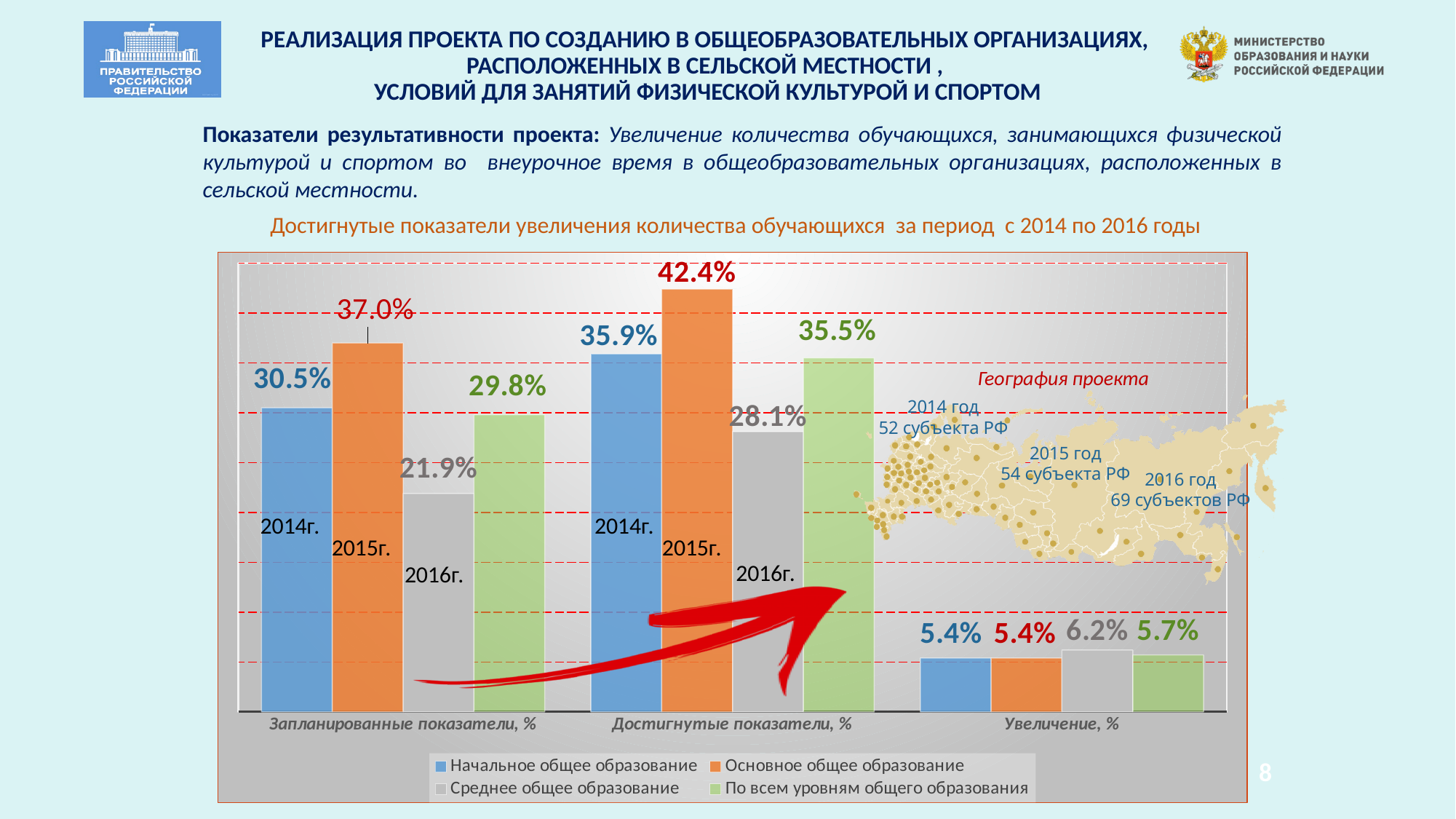
What type of chart is shown on the slide? bar chart Which series has the lowest value in the Запланированные показатели, % category? Среднее общее образование How many categories are shown along the x axis of the chart? 3 What is the value for По всем уровням общего образования in the Увеличение, % category? 5.7% Which colour represents Основное общее образование in the chart? orange What is the value for Среднее общее образование in the Запланированные показатели, % category? 21.9% What is the difference between the Достигнутые values for Основное общее образование and Среднее общее образование? 14.3% How many series does the chart legend list? 4 Which series has the highest value in the Достигнутые показатели, % category? Основное общее образование What is the difference between the Достигнутые and Запланированные values for Начальное общее образование? 5.4% What is the value for Основное общее образование in the Достигнутые показатели, % category? 42.4% Which is larger in the Увеличение, % category: Среднее общее образование or Начальное общее образование? Среднее общее образование